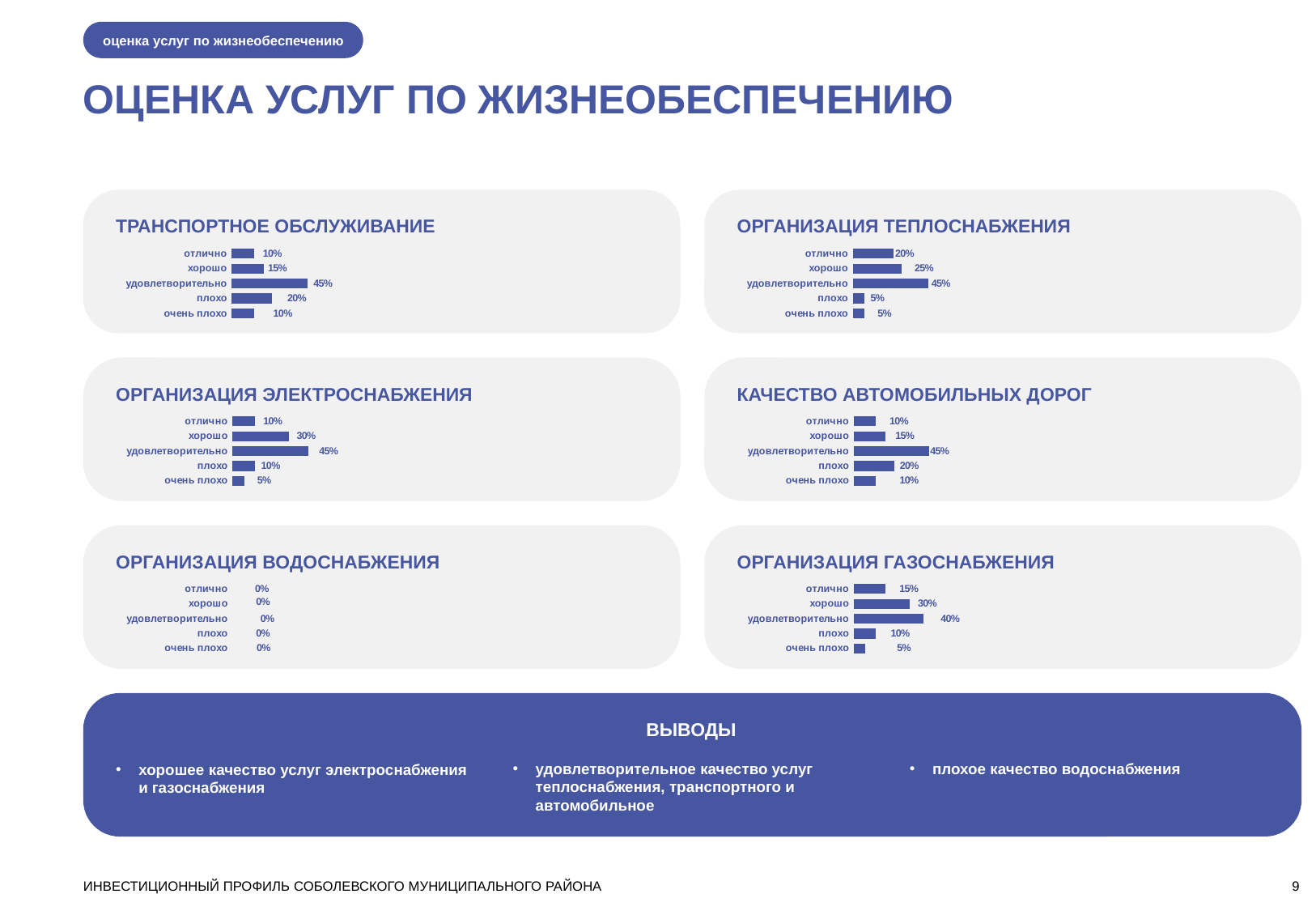
In the chart titled "ОРГАНИЗАЦИЯ ТЕПЛОСНАБЖЕНИЯ", what is the value for "хорошо"? 25% How many categories are shown in the chart titled "ОРГАНИЗАЦИЯ ВОДОСНАБЖЕНИЯ"? 5 In the chart titled "ОРГАНИЗАЦИЯ ТЕПЛОСНАБЖЕНИЯ", which is larger: the value for "отлично" or the value for "плохо"? отлично In the chart titled "ТРАНСПОРТНОЕ ОБСЛУЖИВАНИЕ", what is the difference between the values for "плохо" and "хорошо"? 5% What type of chart is used in the "ОРГАНИЗАЦИЯ ЭЛЕКТРОСНАБЖЕНИЯ" panel? bar chart In the chart titled "ТРАНСПОРТНОЕ ОБСЛУЖИВАНИЕ", what is the value for "удовлетворительно"? 45% In the chart titled "ОРГАНИЗАЦИЯ ГАЗОСНАБЖЕНИЯ", which category has the highest value? удовлетворительно How many bar charts are shown on the slide? 6 In the chart titled "ОРГАНИЗАЦИЯ ВОДОСНАБЖЕНИЯ", what is the value for "отлично"? 0% In the chart titled "ОРГАНИЗАЦИЯ ГАЗОСНАБЖЕНИЯ", what is the value for "хорошо"? 30% In the chart titled "КАЧЕСТВО АВТОМОБИЛЬНЫХ ДОРОГ", what is the difference between the values for "удовлетворительно" and "плохо"? 25% In the chart titled "ОРГАНИЗАЦИЯ ЭЛЕКТРОСНАБЖЕНИЯ", which category has the lowest value? очень плохо